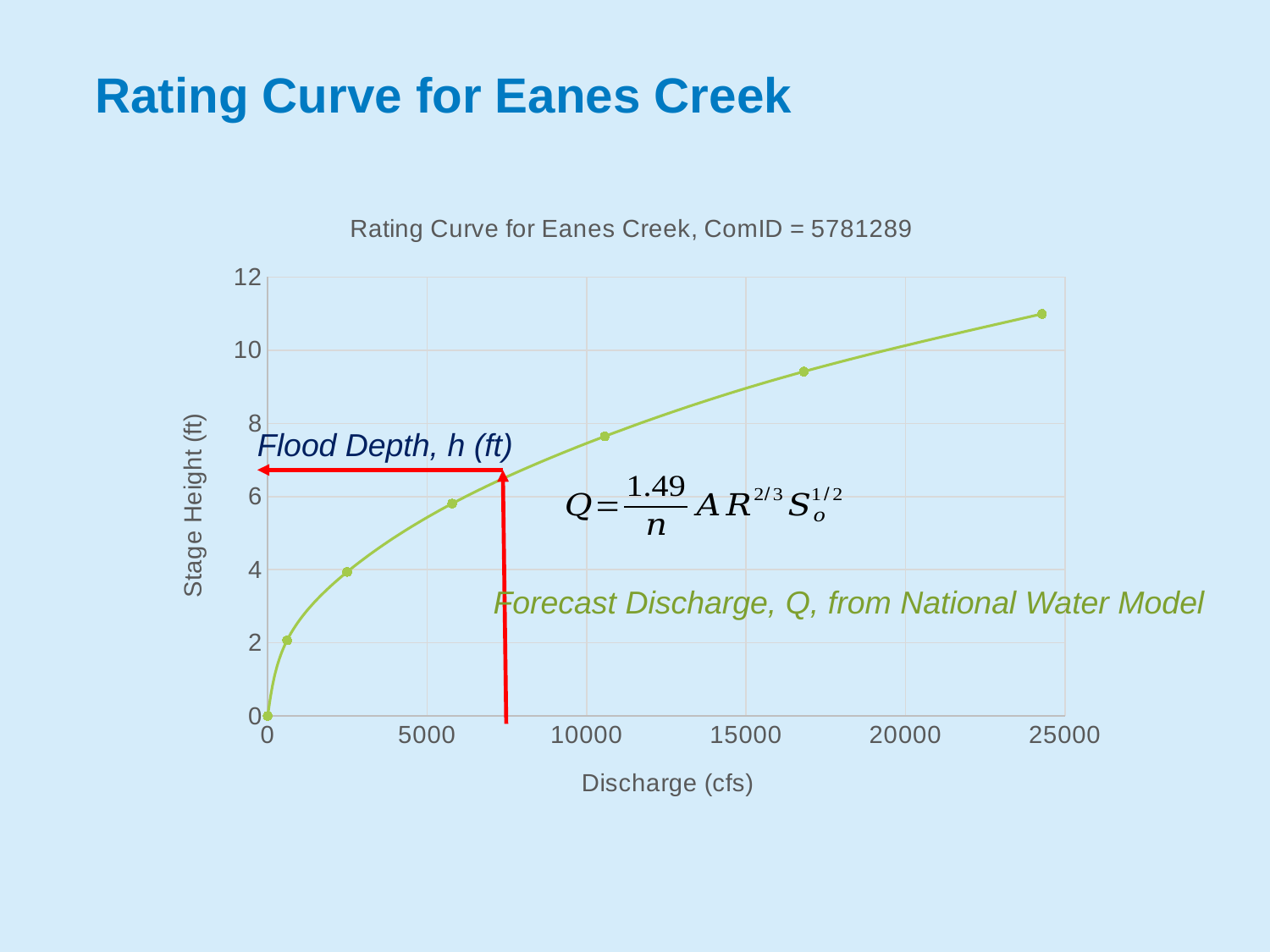
What is the label of the x axis? Discharge (cfs) What is the title printed above the chart? Rating Curve for Eanes Creek, ComID = 5781289 Is the stage height at the data point near 17000 cfs greater or less than 10 ft? less Is the stage height at the data point near 17000 cfs greater or less than 8 ft? greater Is the stage height at the rightmost data point (near 25000 cfs) greater or less than 10 ft? greater What kind of chart is shown on the slide? line chart Which data point has the highest stage height: the one near 25000 cfs or the one near 10000 cfs? the one near 25000 cfs How many data points are marked on the curve? 7 What is the highest value shown on the Stage Height (ft) axis? 12 Does the stage height rise or fall as discharge increases along the x axis? rise What is the stage height at a discharge of 0 cfs? 0